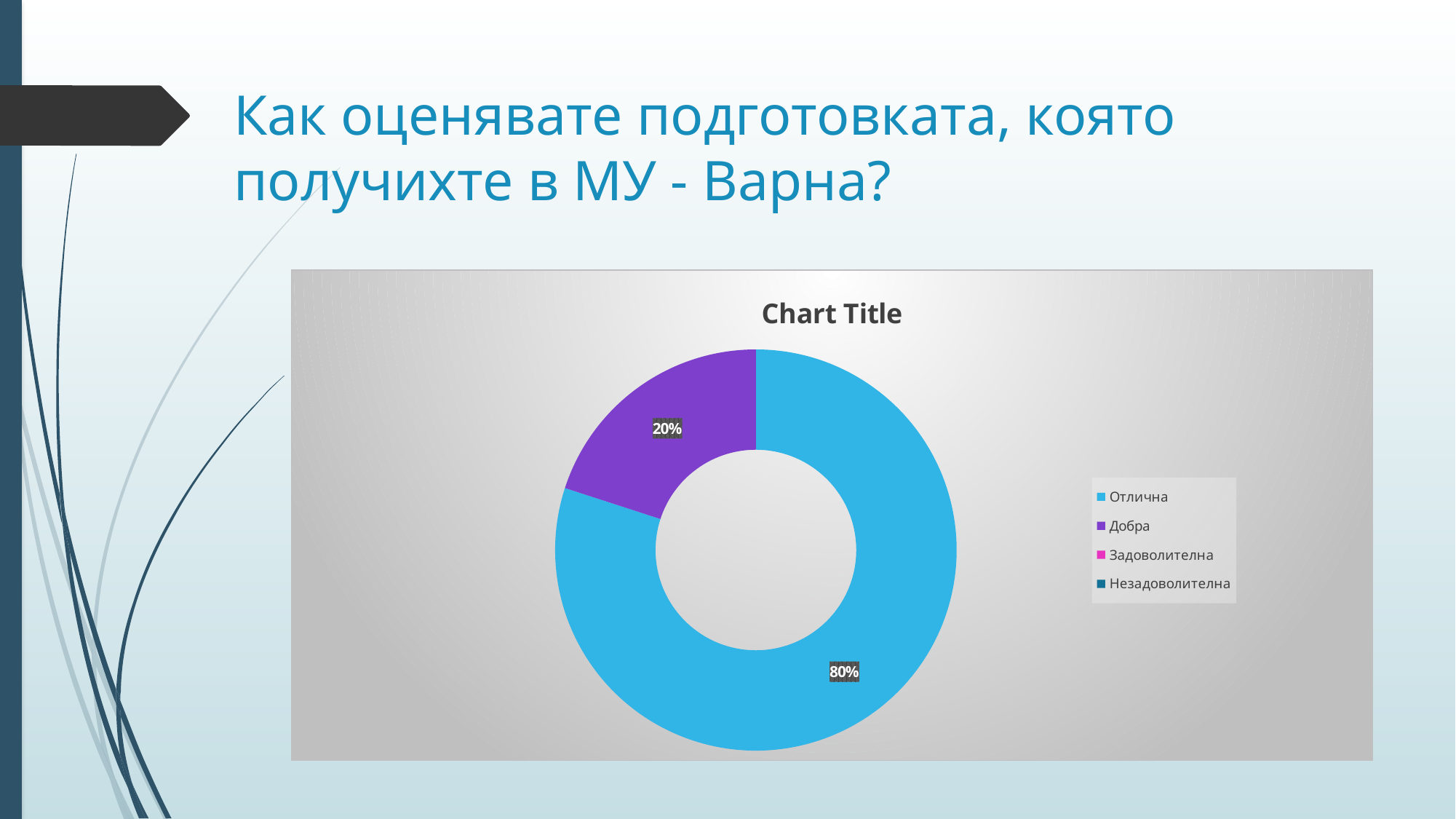
What kind of chart is shown on the slide? doughnut chart Which legend entry is shown in purple? Добра Is the share for Добра greater or less than 50%? less Is the share for Отлична greater or less than 50%? greater Which category has the largest share of the chart? Отлична What is the chart's title? Chart Title What share of the chart does Добра take? 20% What is the difference between the share for Отлична and the share for Добра? 60% What share of the chart does Отлична take? 80% Which is larger, the share for Отлична or the share for Добра? Отлична How many categories does the legend list? 4